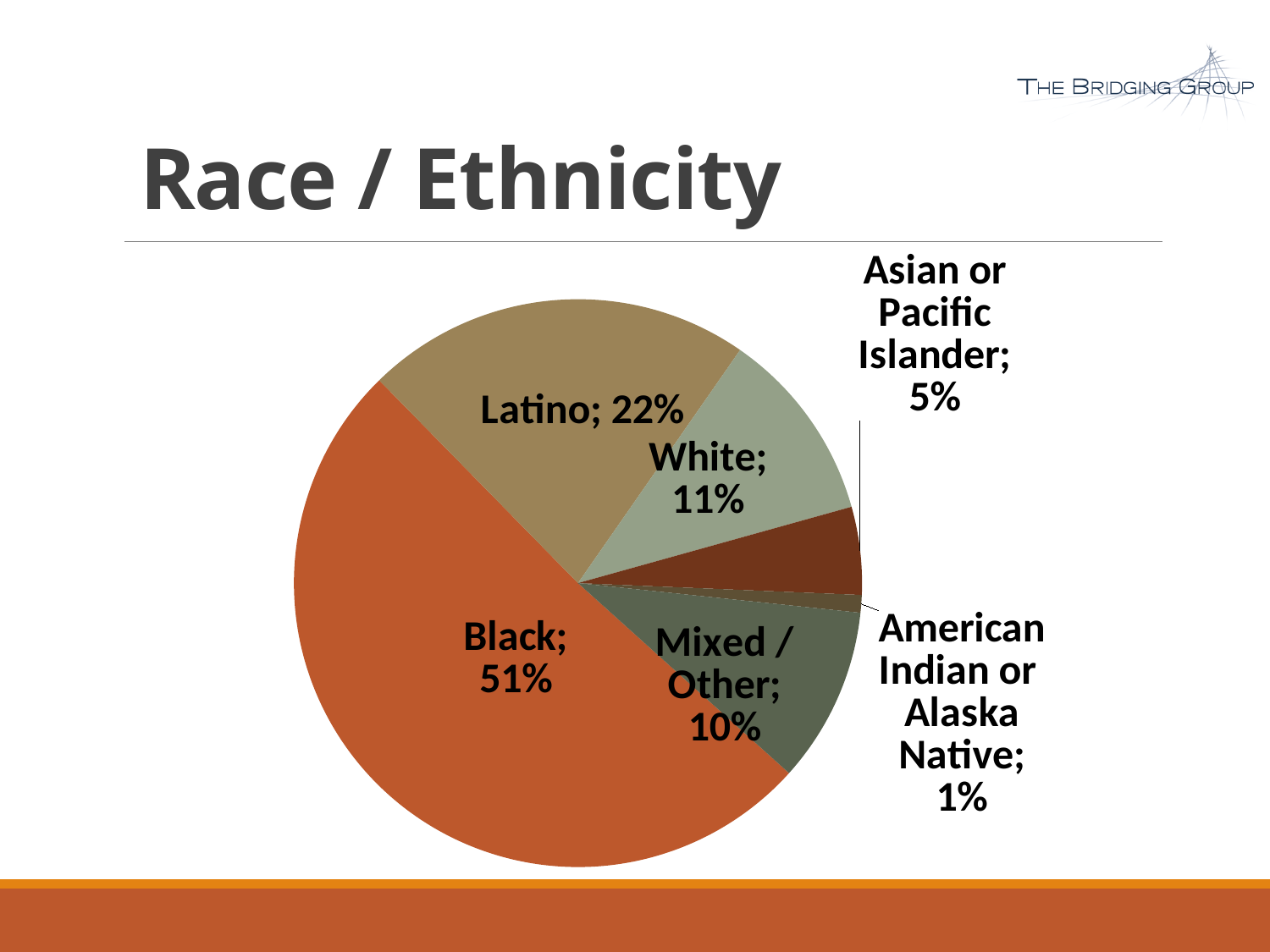
What percentage of the pie is White? 11% How many slices does the pie chart have? 6 What is the title of the slide? Race / Ethnicity What percentage of the pie is Asian or Pacific Islander? 5% Which is larger, the White slice or the Mixed / Other slice? White What percentage of the pie is Black? 51% What percentage of the pie is American Indian or Alaska Native? 1% Which category has the largest share of the pie? Black What is the difference in percentage points between Black and Latino? 29 What type of chart is shown on the slide? pie chart Which category has the smallest share of the pie? American Indian or Alaska Native What percentage of the pie is Latino? 22%